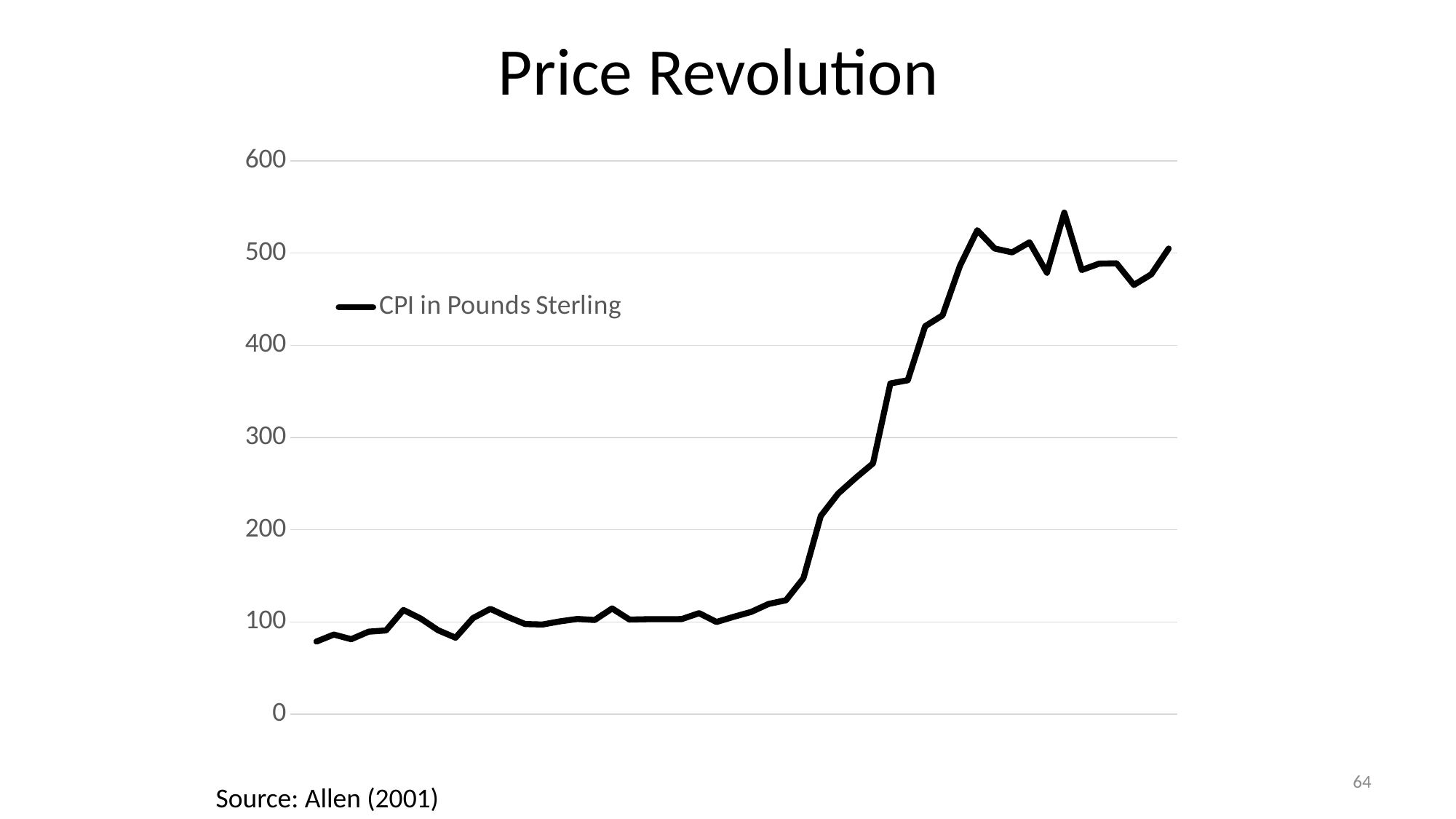
Overall, does the CPI in Pounds Sterling line rise or fall from left to right? rise What kind of chart is shown on the slide? line chart Is the lowest point of the CPI in Pounds Sterling line greater or less than 100? less Is the first (leftmost) value of the CPI in Pounds Sterling line greater or less than 100? less Which is larger, the first value or the last value of the CPI in Pounds Sterling line? the last value What is the title of the chart? Price Revolution Is the highest point of the CPI in Pounds Sterling line greater or less than 600? less What series name does the legend show? CPI in Pounds Sterling How many series does the legend list? 1 What is the highest tick value shown on the vertical axis? 600